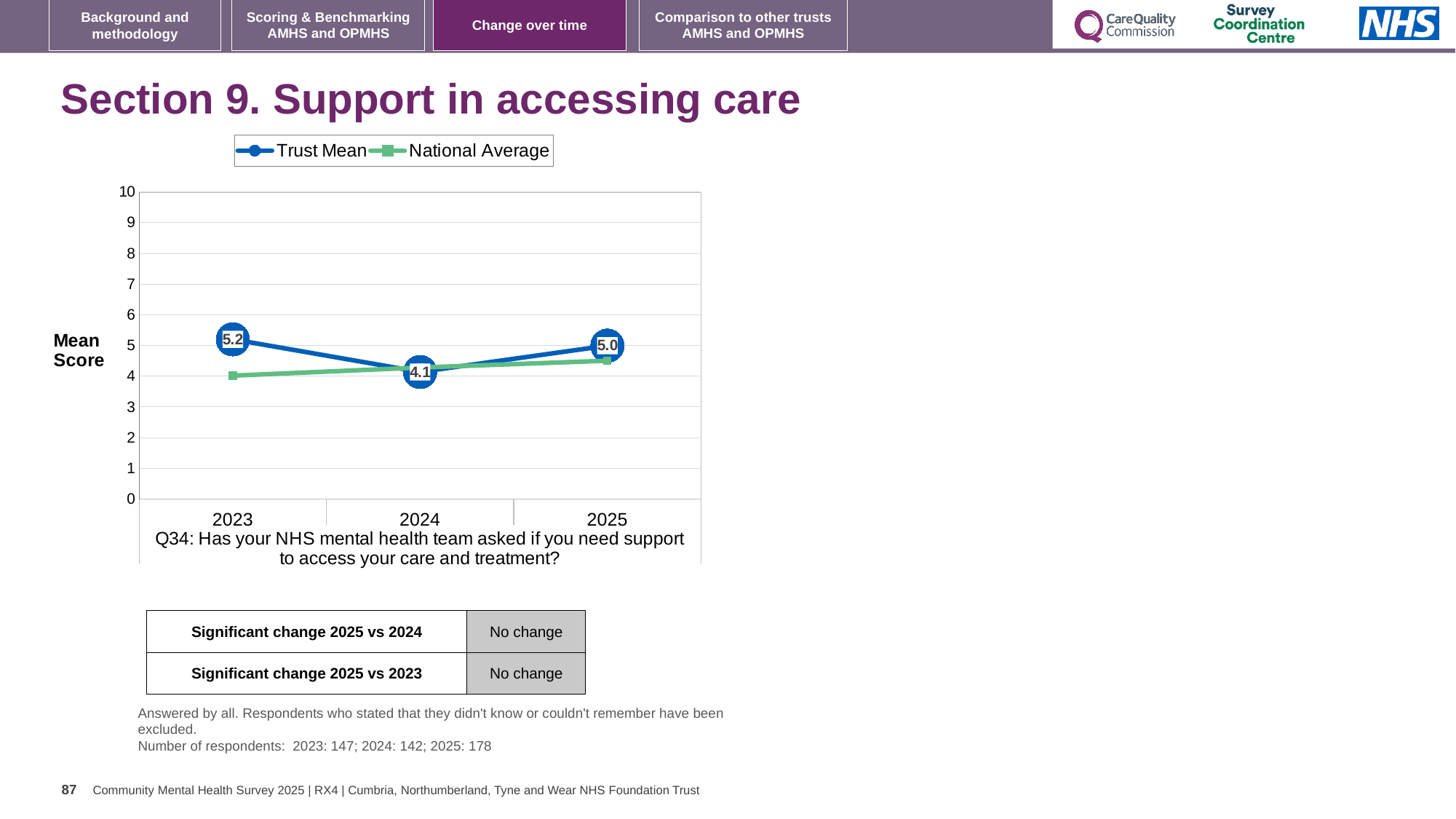
What is the Trust Mean score for 2023? 5.2 How many series does the legend list? 2 What is the Trust Mean score for 2025? 5.0 In which year is the Trust Mean score highest? 2023 How many years are plotted on the x axis? 3 Is the National Average value for 2023 greater or less than 5? less In which year is the Trust Mean score lowest? 2024 What is the difference between the Trust Mean scores for 2023 and 2024? 1.1 What is the Trust Mean score for 2024? 4.1 Is the National Average value for 2025 greater or less than 4? greater What kind of chart is shown on the slide? line chart Which is larger in 2023, the Trust Mean or the National Average? Trust Mean